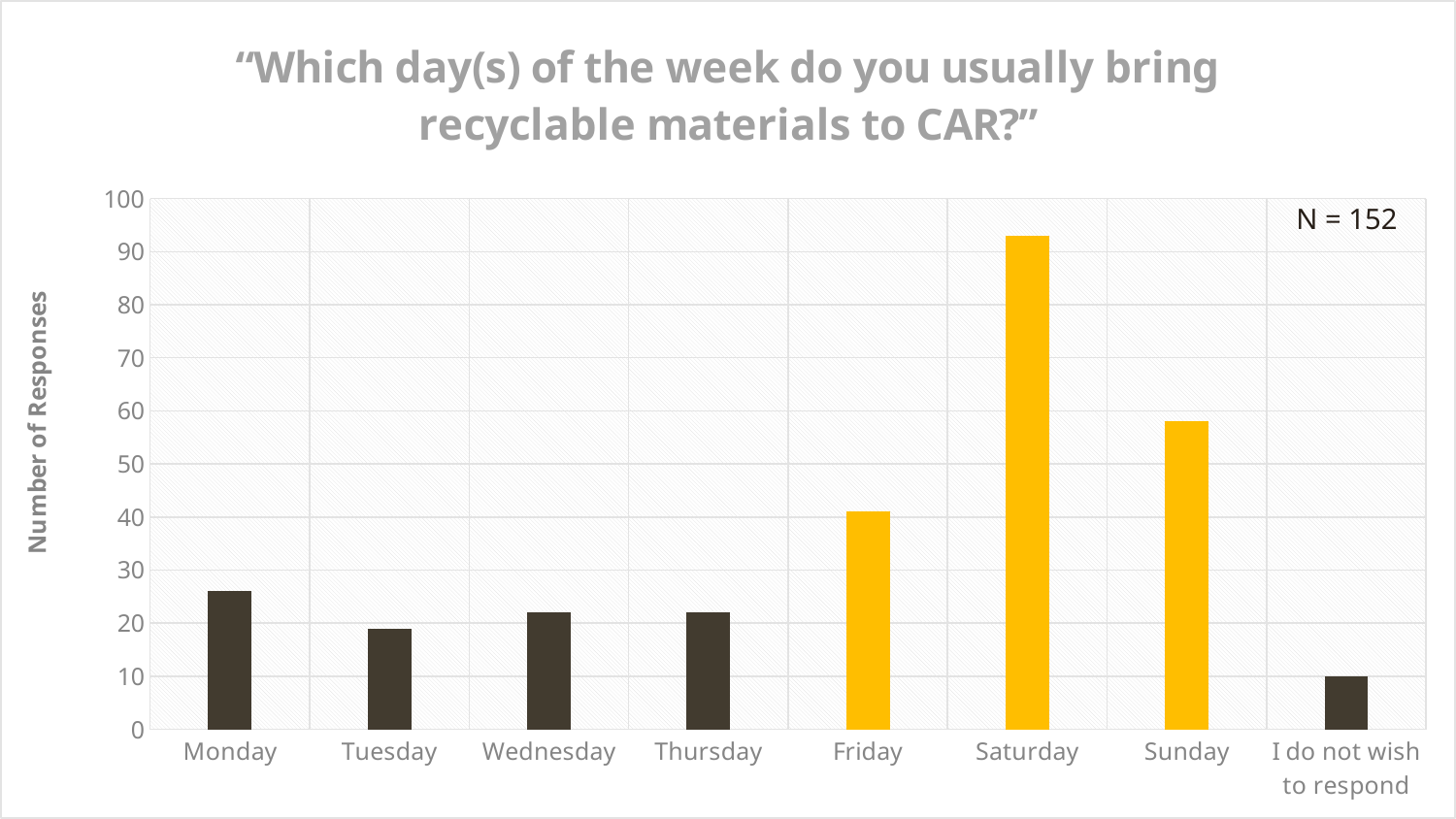
What sample size (N) is stated on the chart? N = 152 Which category has the lowest number of responses? I do not wish to respond Is the value for Saturday greater or less than 90? greater Which category has the highest number of responses? Saturday What is the label of the y axis? Number of Responses What kind of chart is shown on the slide? bar chart Which has more responses, Sunday or Friday? Sunday How many categories are shown on the x axis? 8 Is the value for Friday greater or less than 50? less Is the value for Sunday greater or less than 50? greater Which has more responses, Monday or Tuesday? Monday